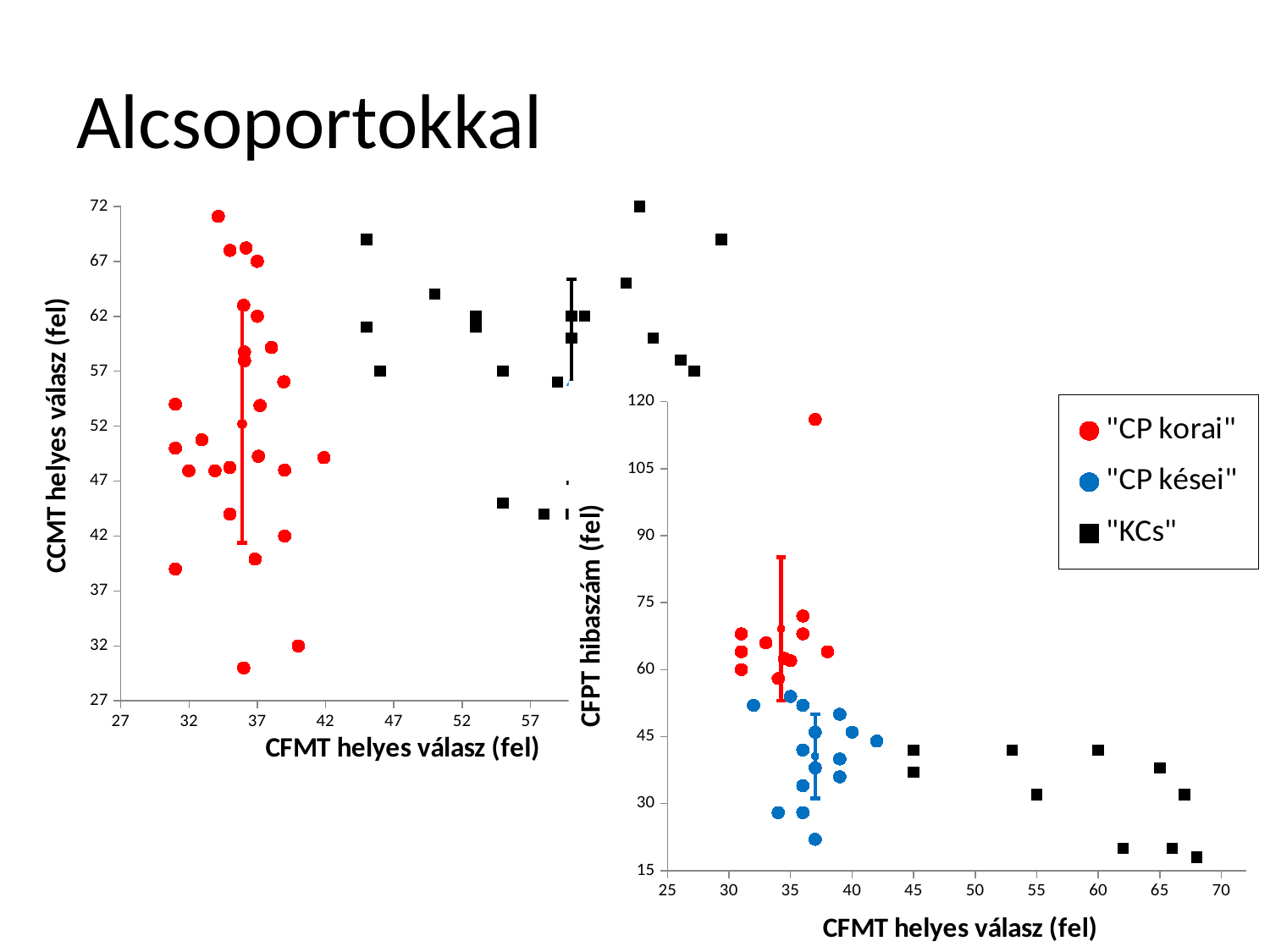
In the right chart, is the CFPT hibaszám of the black "KCs" point with the highest CFMT helyes válasz (around 68) greater or less than 30? less What are the three series named in the legend? "CP korai", "CP kései", "KCs" In the right chart, which series contains the point with the highest CFPT hibaszám? "CP korai" In the left chart, is the lowest red "CP korai" point greater or less than 32 on the CCMT helyes válasz axis? less In the right chart, which series has generally higher CFPT hibaszám values, "CP korai" or "KCs"? "CP korai" In the legend, what colour and shape is the marker for "CP kései"? blue circle In the left chart, as CFMT helyes válasz increases along the x axis, does CCMT helyes válasz generally rise or fall? rise In the left chart, is the highest red "CP korai" point greater or less than 67 on the CCMT helyes válasz axis? greater In the right chart, as CFMT helyes válasz increases along the x axis, does CFPT hibaszám generally rise or fall? fall How many series does the legend list? 3 What kind of chart is the left chart on the slide? scatter chart